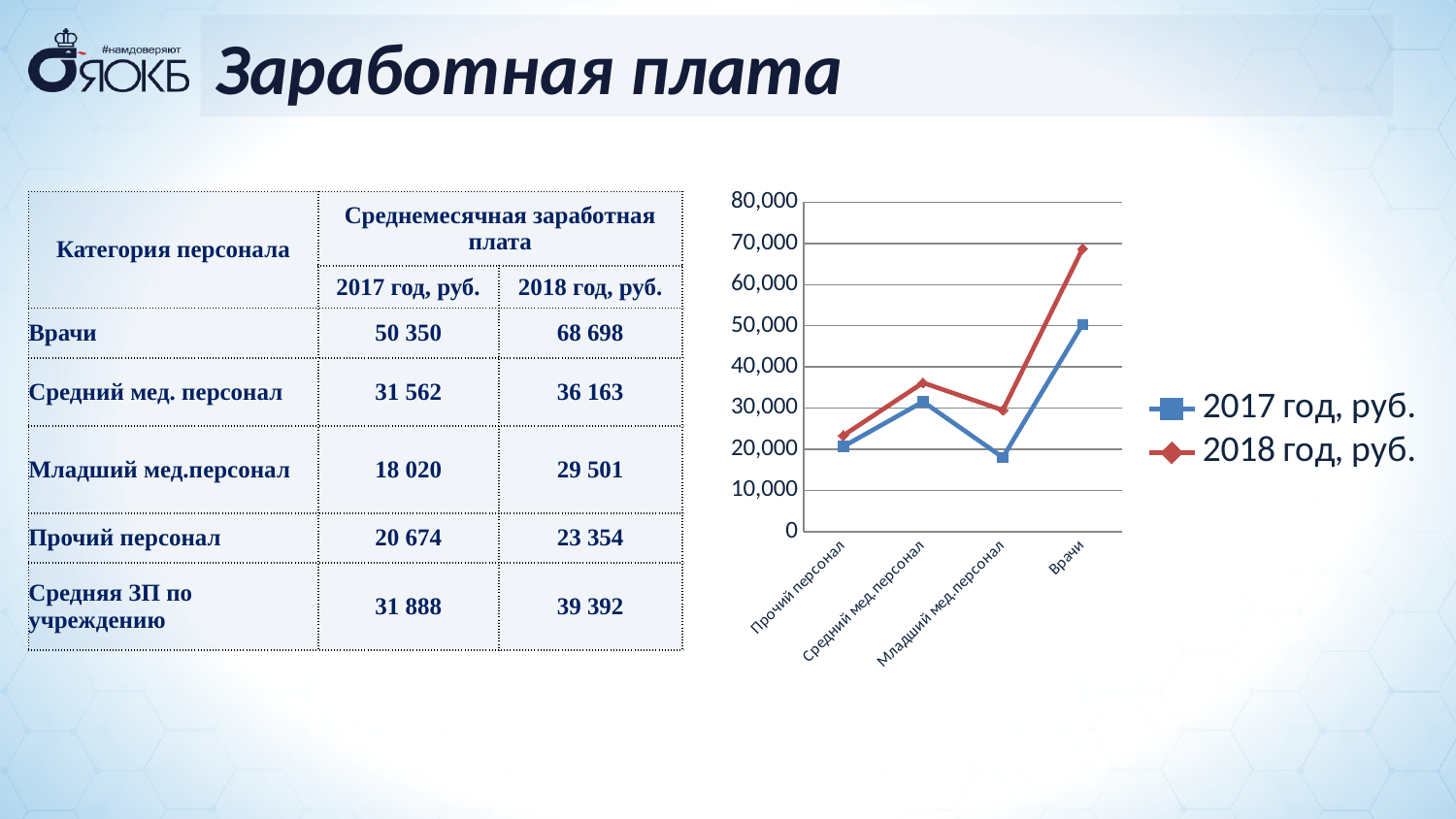
Which category has the lowest value for the 2018 год, руб. series? Прочий персонал Which colour is used for the 2018 год, руб. series in the chart? red Is the 2018 год, руб. value for Средний мед.персонал greater or less than 30,000? greater Do the values rise or fall from Младший мед.персонал to Врачи for the 2017 год, руб. series? rise Is the 2017 год, руб. value for Прочий персонал greater or less than 30,000? less For Врачи, which series has the larger value, 2017 год, руб. or 2018 год, руб.? 2018 год, руб. Is the 2018 год, руб. value for Врачи greater or less than 60,000? greater How many personnel categories are plotted along the x axis of the chart? 4 According to the table on the slide, what is the 2018 average monthly salary for Врачи? 68 698 How many series does the chart legend list? 2 Which category has the highest value for the 2018 год, руб. series? Врачи What kind of chart is shown on the slide? line chart